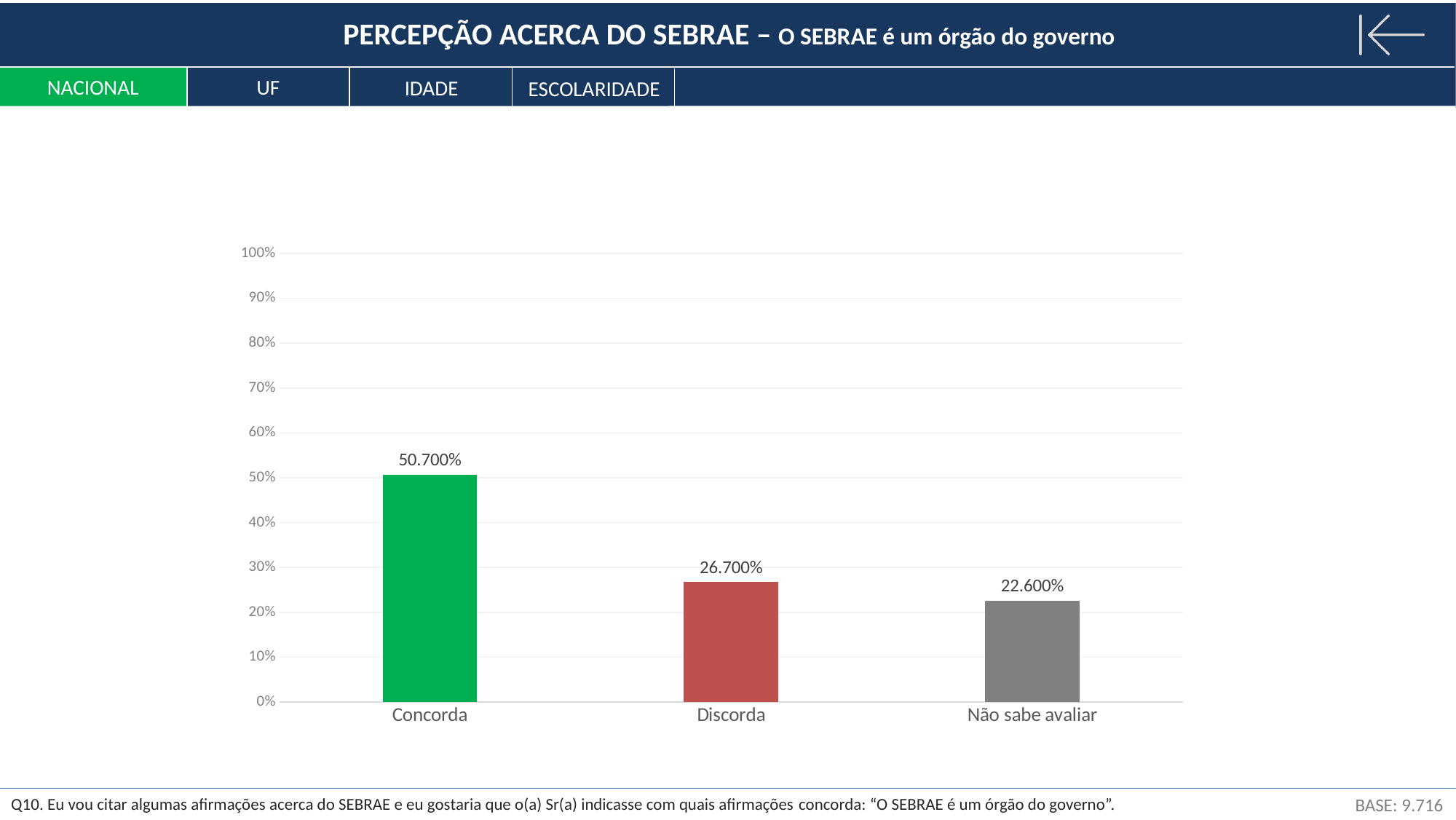
What is the difference between the values for Concorda and Discorda? 24.000% What is the value for Não sabe avaliar? 22.600% What is the difference between the values for Discorda and Não sabe avaliar? 4.100% What colour is the bar for Concorda? green Which is larger, the value for Discorda or the value for Não sabe avaliar? Discorda What is the value for Discorda? 26.700% What kind of chart is shown on the slide? bar chart What is the value for Concorda? 50.700% Which category has the highest value? Concorda Which category has the lowest value? Não sabe avaliar Is the value for Concorda greater or less than 50%? greater How many categories are shown on the x axis? 3